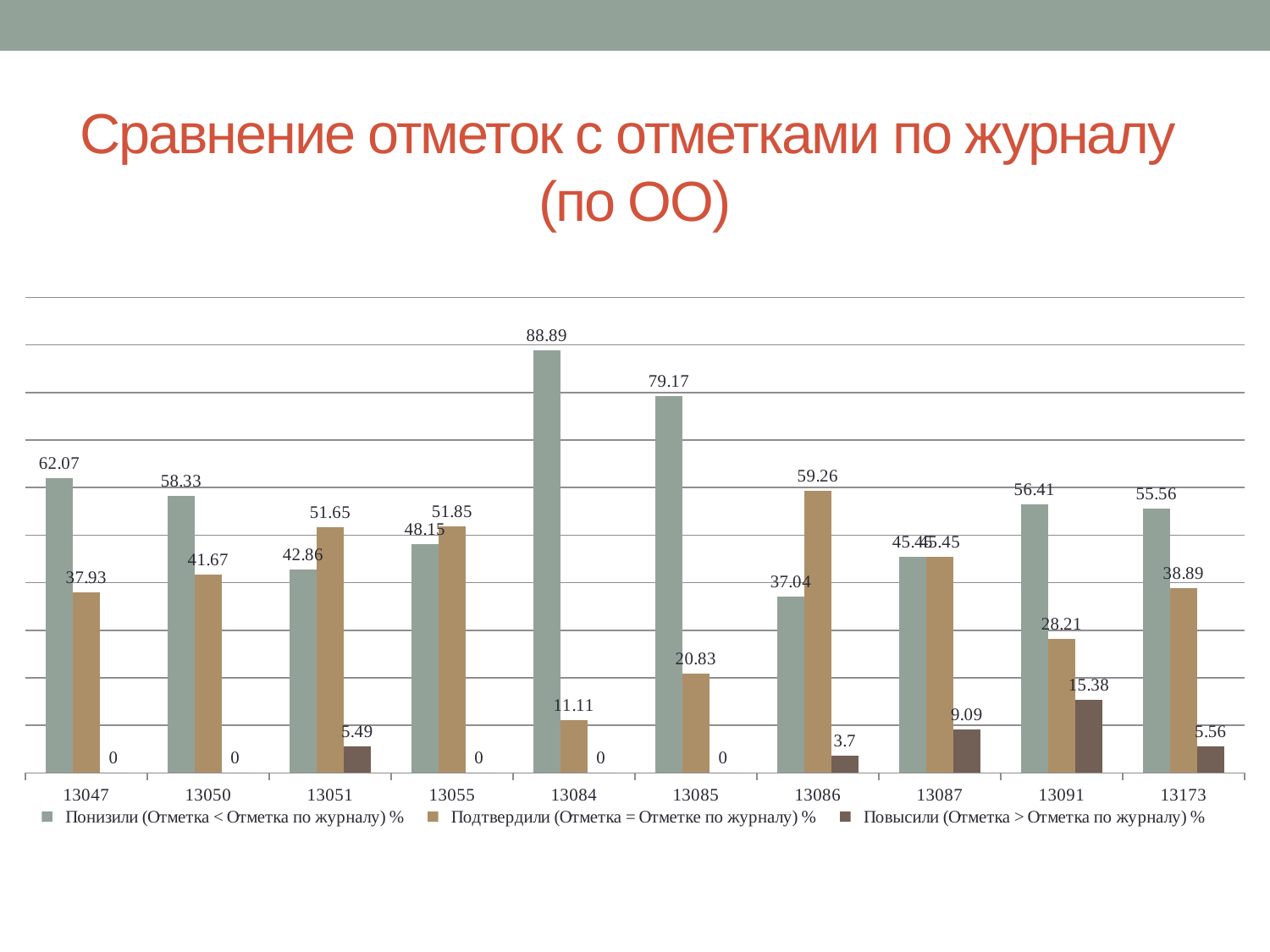
What is the value of the Понизили series for category 13084? 88.89 What is the difference between the Понизили and Подтвердили values for category 13047? 24.14 How many categories are shown on the x axis? 10 Which category has the highest value in the Понизили series? 13084 What is the value of the Повысили series for category 13091? 15.38 What is the value of the Повысили series for category 13050? 0 What is the value of the Подтвердили series for category 13086? 59.26 Which category has the lowest value in the Подтвердили series? 13084 What kind of chart is shown on the slide? Bar chart For category 13055, which is larger: the Понизили value or the Подтвердили value? Подтвердили How many series does the legend list? 3 What is the title of the slide? Сравнение отметок с отметками по журналу (по ОО)